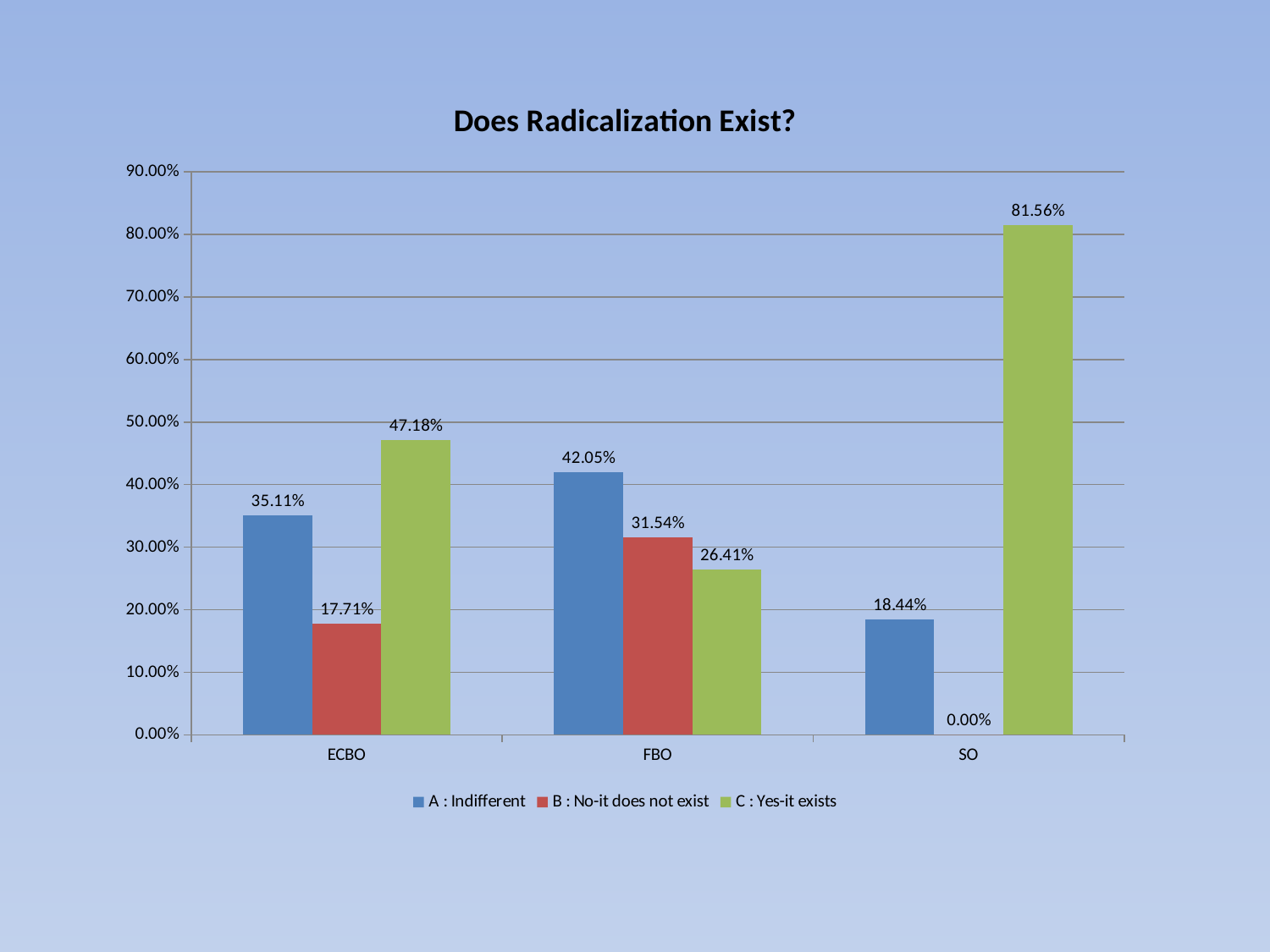
How many series does the legend list? 3 How many categories are shown on the x axis? 3 What is the value for 'C : Yes-it exists' in the SO category? 81.56% Which category has the lowest value for 'B : No-it does not exist'? SO What is the title of the chart? Does Radicalization Exist? What is the difference between 'C : Yes-it exists' and 'A : Indifferent' in the ECBO category? 12.07% What kind of chart is shown on the slide? bar chart In the FBO category, which is larger: 'B : No-it does not exist' or 'C : Yes-it exists'? B : No-it does not exist What is the value for 'B : No-it does not exist' in the ECBO category? 17.71% Which category has the highest value for 'C : Yes-it exists'? SO Is the value for 'A : Indifferent' in the SO category greater or less than 20.00%? less What is the value for 'A : Indifferent' in the FBO category? 42.05%